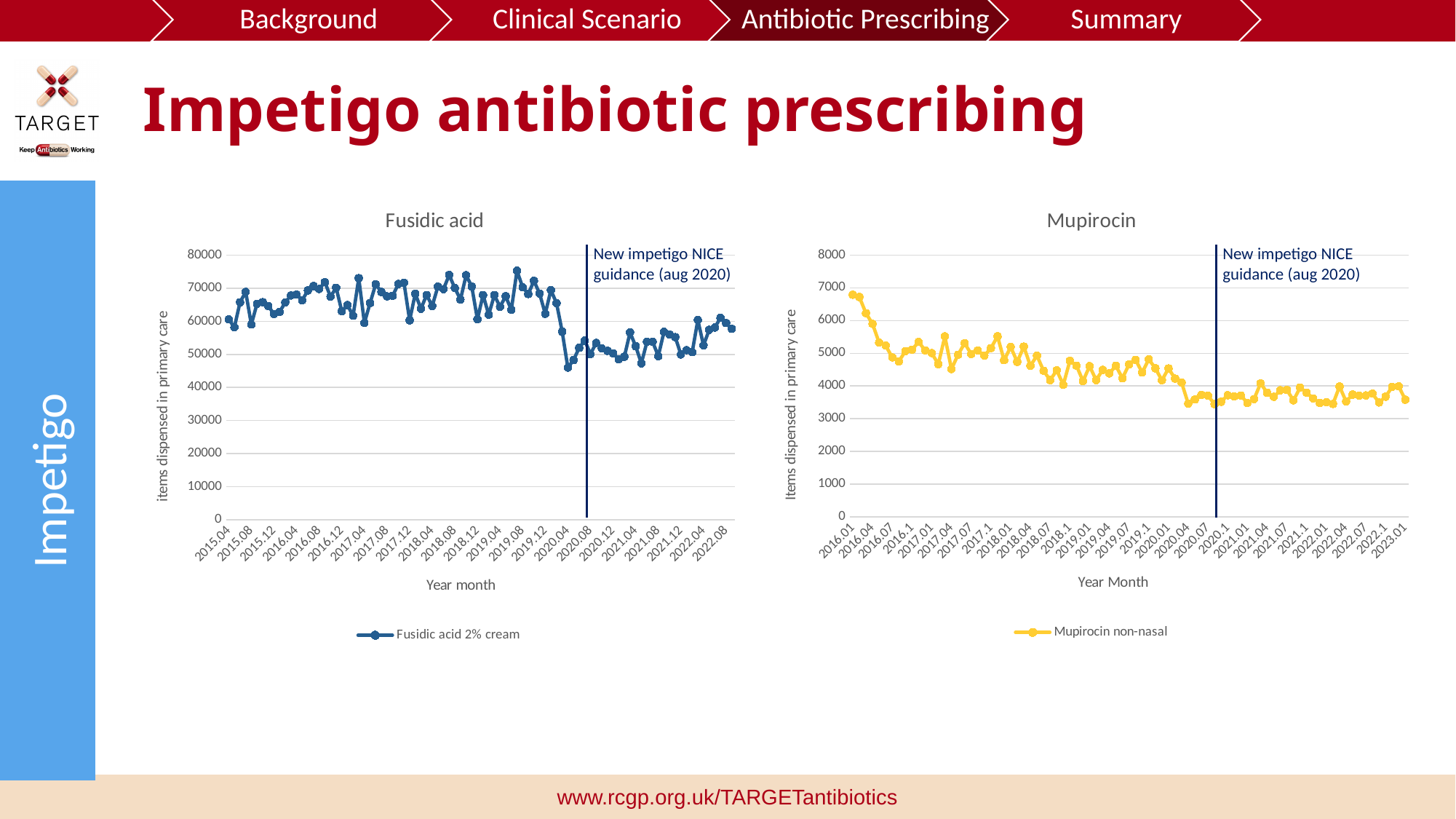
In the Mupirocin chart, is the value for 2016.01 greater or less than 6000? greater What is the legend entry in the Mupirocin chart? Mupirocin non-nasal What event does the vertical line in the Fusidic acid chart mark? New impetigo NICE guidance (aug 2020) How many series does the legend of the Fusidic acid chart list? 1 In the Fusidic acid chart, are the values after the NICE guidance line generally higher or lower than the values before it? Lower How many series does the legend of the Mupirocin chart list? 1 In the Fusidic acid chart, is the value for 2016.08 greater or less than 50000? greater In the Mupirocin chart, is the value for 2022.07 greater or less than 5000? less What kind of chart is the Mupirocin chart? Line chart In the Mupirocin chart, which is larger: the value for 2016.01 or the value for 2023.01? 2016.01 What kind of chart is the Fusidic acid chart? Line chart In the Mupirocin chart, do the values generally rise or fall from 2016.01 to 2023.01? Fall